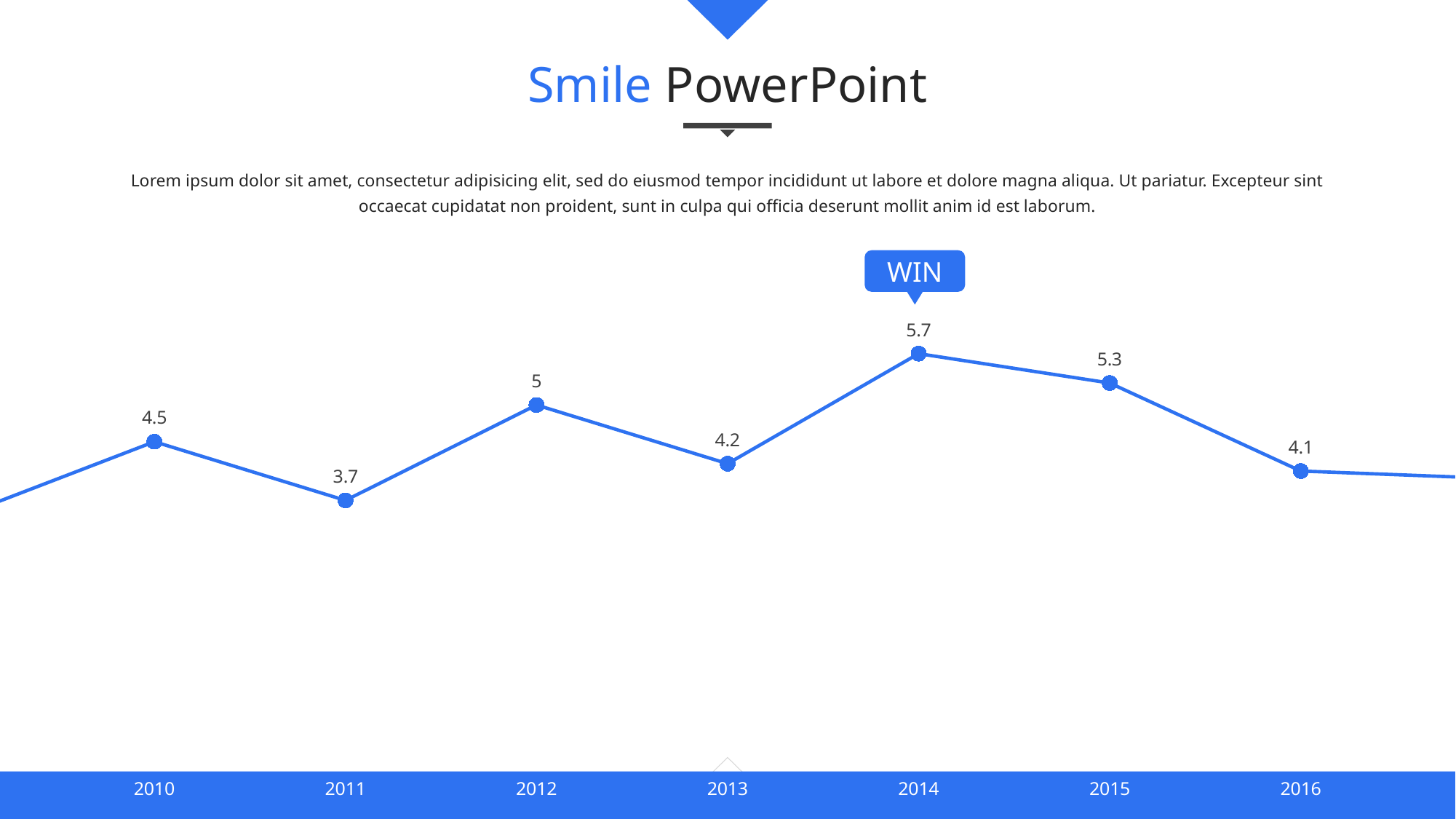
How many years are labelled on the x axis? 7 Which year is marked with the 'WIN' callout? 2014 What is the value for 2016? 4.1 What is the value for 2014? 5.7 What kind of chart is shown on the slide? line chart Which year has the highest value? 2014 Which year has the lowest value? 2011 What is the value for 2012? 5 What is the value for 2010? 4.5 What is the value for 2011? 3.7 What is the difference between the values for 2014 and 2013? 1.5 Which is larger, the value for 2015 or the value for 2012? 2015